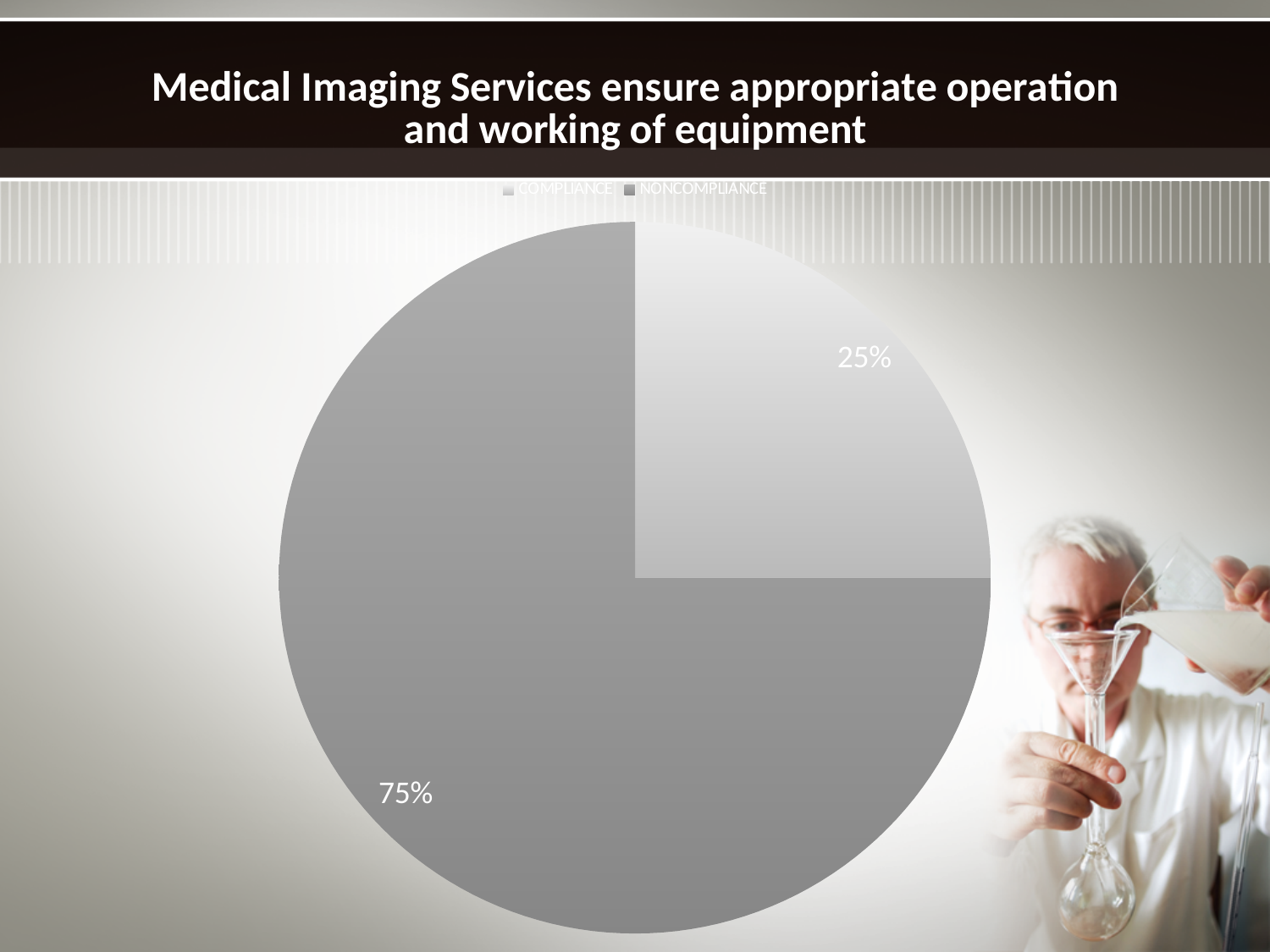
Which is larger, the COMPLIANCE slice or the NONCOMPLIANCE slice? NONCOMPLIANCE How many slices does the pie chart have? 2 What is the difference in percentage points between the NONCOMPLIANCE and COMPLIANCE slices? 50% Which slice of the pie is the largest? NONCOMPLIANCE How many entries does the legend list? 2 Which legend entry is listed first? COMPLIANCE What do the two slices of the pie add up to? 100% Which slice of the pie is the smallest? COMPLIANCE What share of the pie does NONCOMPLIANCE take? 75% What kind of chart is shown on the slide? pie chart What is the title of the slide containing the pie chart? Medical Imaging Services ensure appropriate operation and working of equipment What share of the pie does COMPLIANCE take? 25%